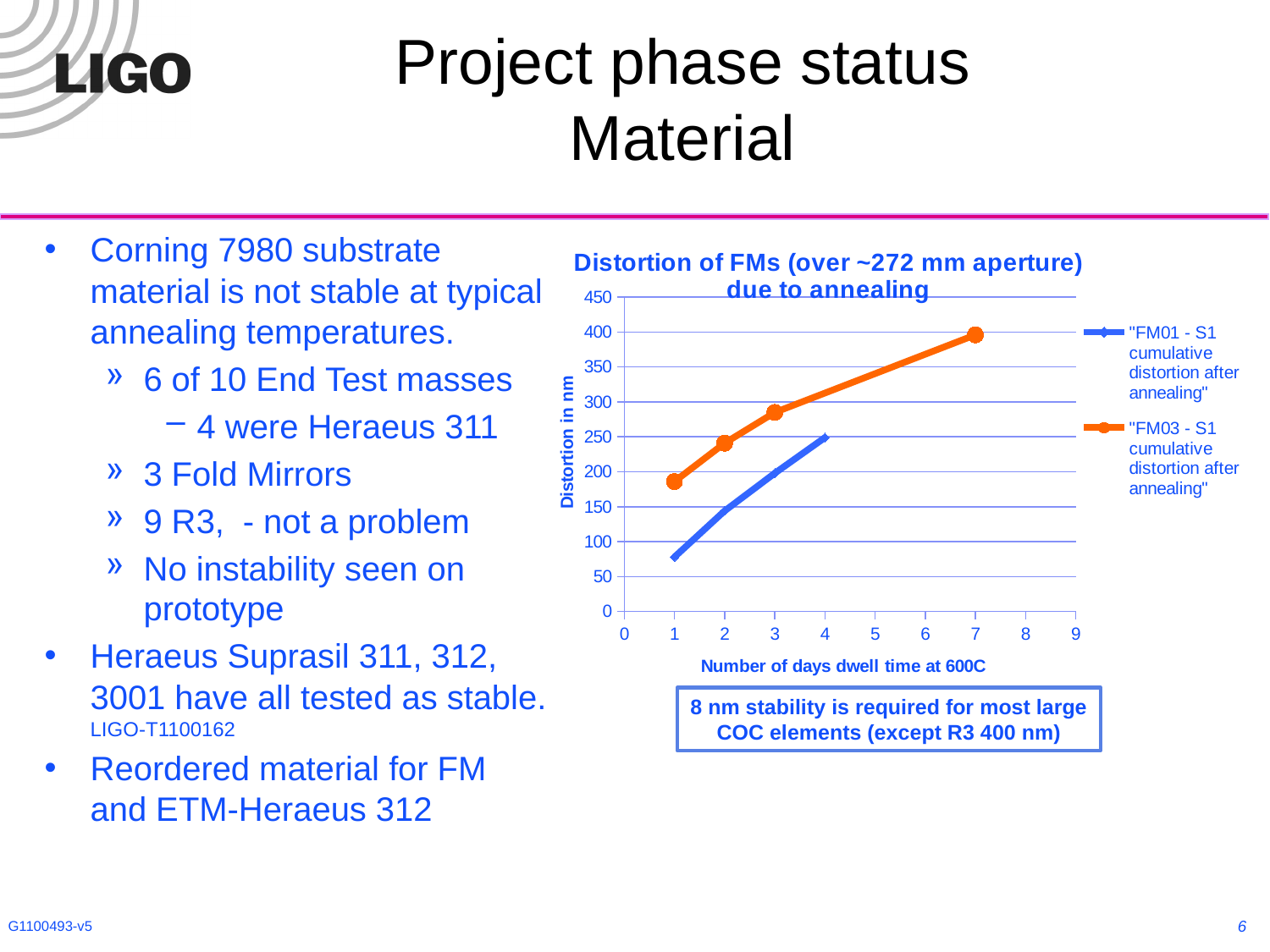
Is the value for FM01 at 1 day greater or less than 100? less Is the value for FM03 at 3 days greater or less than 250? greater Do the values for the FM01 series rise or fall as the number of days increases? rise Is the value for FM03 at 7 days greater or less than 350? greater What is the title of the chart? Distortion of FMs (over ~272 mm aperture) due to annealing Which series reaches the highest distortion value on the chart? FM03 How many series does the legend of the chart list? 2 What is the label of the vertical axis of the chart? Distortion in nm What kind of chart is shown on the slide? line chart Do the values for the FM03 series rise or fall as the number of days increases? rise At 3 days, which series has the larger distortion, FM01 or FM03? FM03